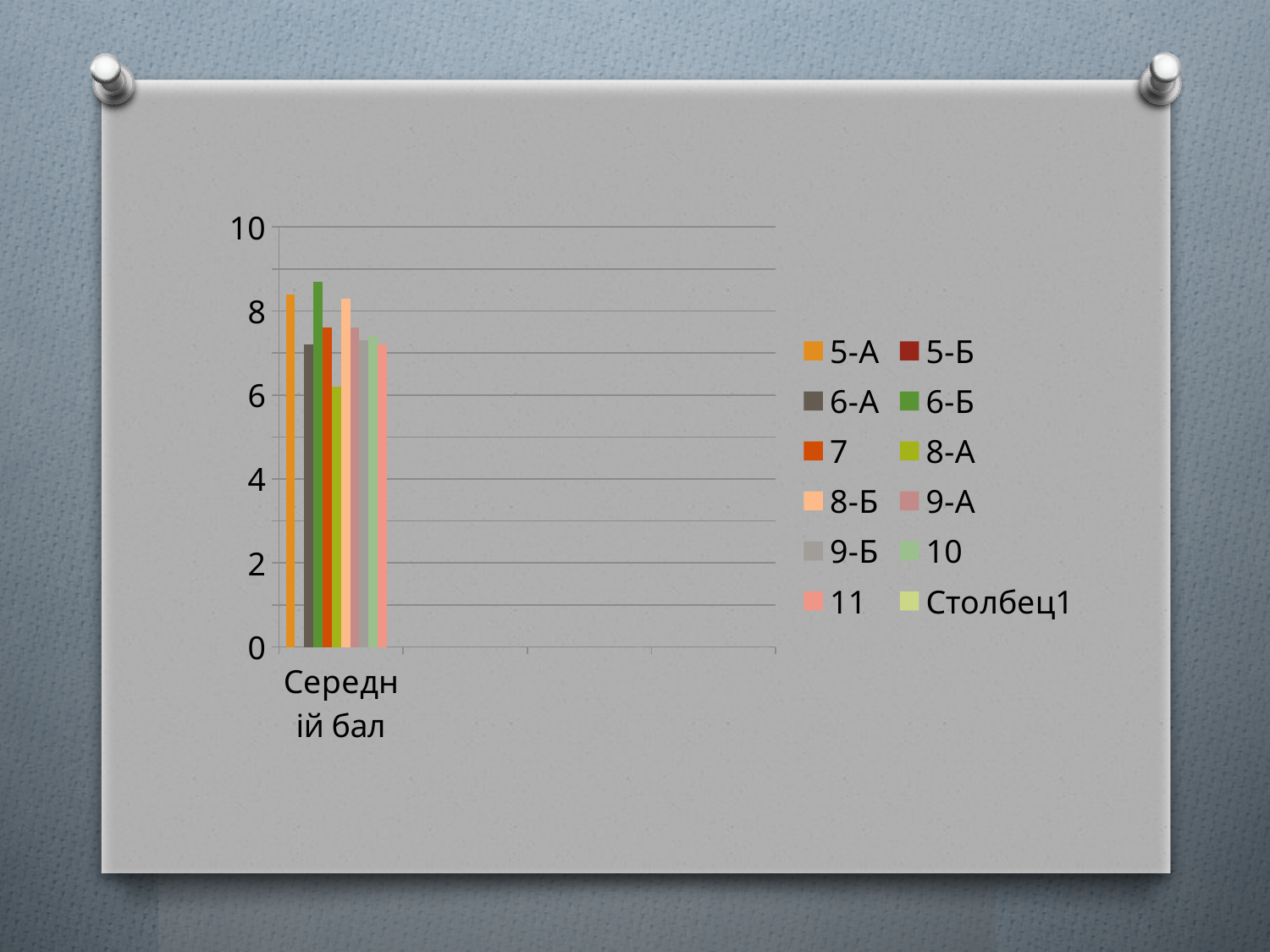
What kind of chart is shown on the slide? bar chart How many series does the legend list? 12 Which series has the highest bar? 6-Б How many categories are shown on the x axis? 1 Is the value for 11 greater or less than 8? less Is the value for 6-Б greater or less than 8? greater Which series has the lowest bar? 8-А Which is larger, the value for 6-Б or the value for 7? 6-Б Is the value for 8-А greater or less than 8? less Which is larger, the value for 5-А or the value for 8-А? 5-А What is the label of the category on the x axis? Середній бал